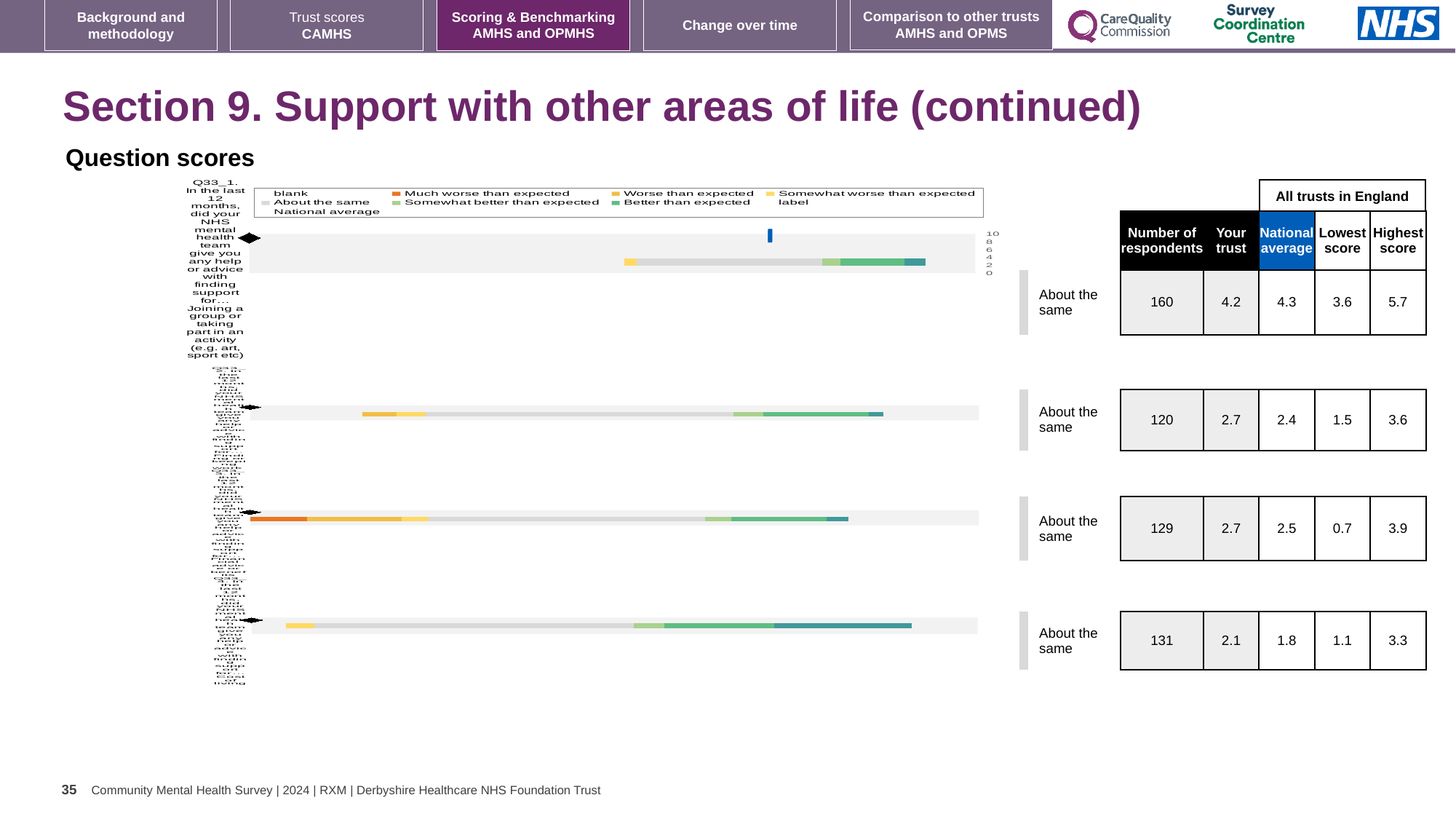
In the table beside the chart, which row has the highest number of respondents? the first row (160) In the table beside the chart, what is the lowest score for the third row? 0.7 Which bar, counting from the top, is the only one with an orange 'Much worse than expected' segment? the third bar In the table beside the chart, what is the difference between 'Your trust' and 'National average' for the second row? 0.3 What colour does the legend use for 'Much worse than expected'? orange In the table beside the chart, what is the 'Your trust' score for the first row? 4.2 In the table beside the chart, what is the number of respondents for the first row (Joining a group or taking part in an activity)? 160 In the table beside the chart, is the 'Your trust' score or the 'National average' larger for the first row? National average How many horizontal bars are plotted in the chart? 4 Which legend entry is shown in light grey? About the same What kind of chart is shown under 'Question scores'? bar chart